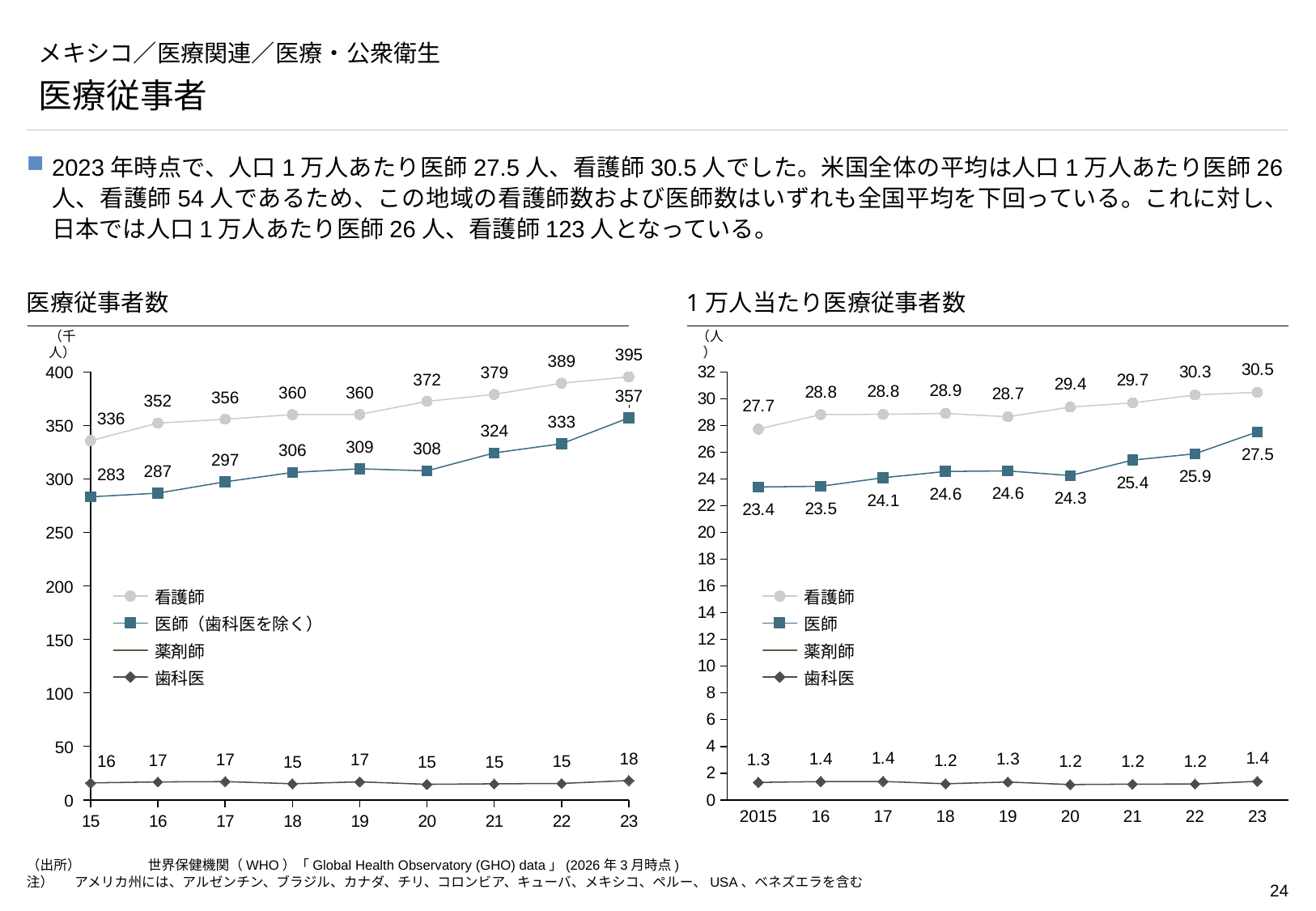
In the chart titled 1万人当たり医療従事者数 (right), what is the value for 看護師 in 2015? 27.7 In the chart titled 医療従事者数 (left), how many series does the legend list? 4 In the chart titled 医療従事者数 (left), what is the difference between 看護師 and 医師（歯科医を除く） in 23? 38 In the chart titled 1万人当たり医療従事者数 (right), in which year is the 医師 value lowest? 2015 In the chart titled 1万人当たり医療従事者数 (right), what is the value for 医師 in 23? 27.5 In the chart titled 医療従事者数 (left), what is the value for 看護師 in 23? 395 In the chart titled 1万人当たり医療従事者数 (right), how many years are plotted on the x axis? 9 In the chart titled 医療従事者数 (left), what is the value for 医師（歯科医を除く） in 19? 309 In the chart titled 医療従事者数 (left), in which year is the 歯科医 value highest? 23 What kind of chart is the chart titled 1万人当たり医療従事者数 (right)? line chart In the chart titled 1万人当たり医療従事者数 (right), what is the difference between 看護師 and 医師 in 23? 3.0 In the chart titled 医療従事者数 (left), does the 医師（歯科医を除く） series generally rise or fall from 15 to 23? rise